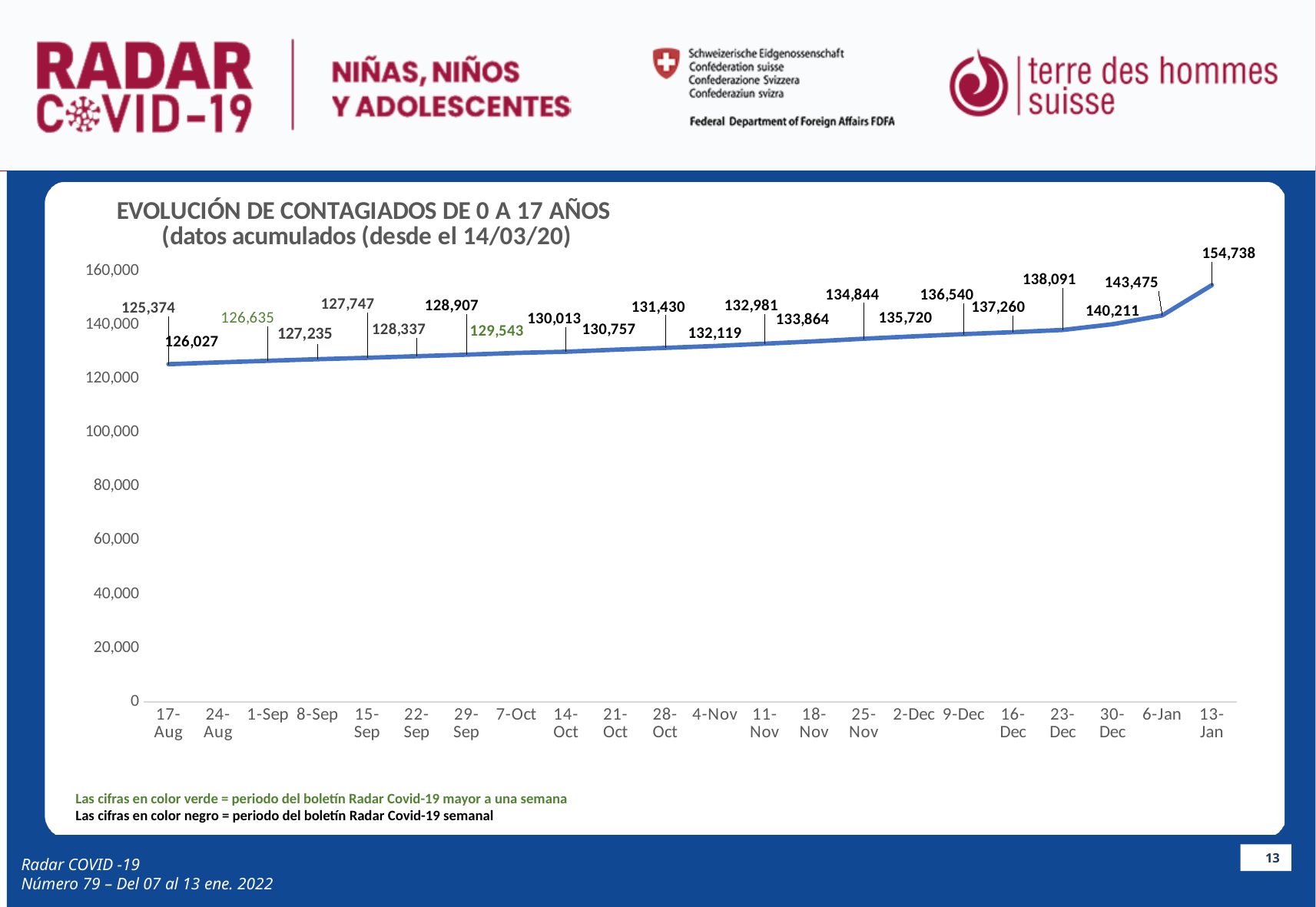
What is the value shown for 30-Dec? 140,211 Which date has the highest value on the chart? 13-Jan How many dates are shown on the x axis of the chart? 22 What is the value shown for 13-Jan? 154,738 Which is larger, the value for 13-Jan or the value for 17-Aug? 13-Jan What type of chart is shown on the slide? Line chart What is the value shown for 17-Aug? 125,374 What is the value shown for 6-Jan? 143,475 Which date has the lowest value on the chart? 17-Aug What is the difference between the values for 13-Jan and 6-Jan? 11,263 Is the value for 17-Aug greater or less than 140,000? less Do the values rise or fall from 17-Aug to 13-Jan? Rise